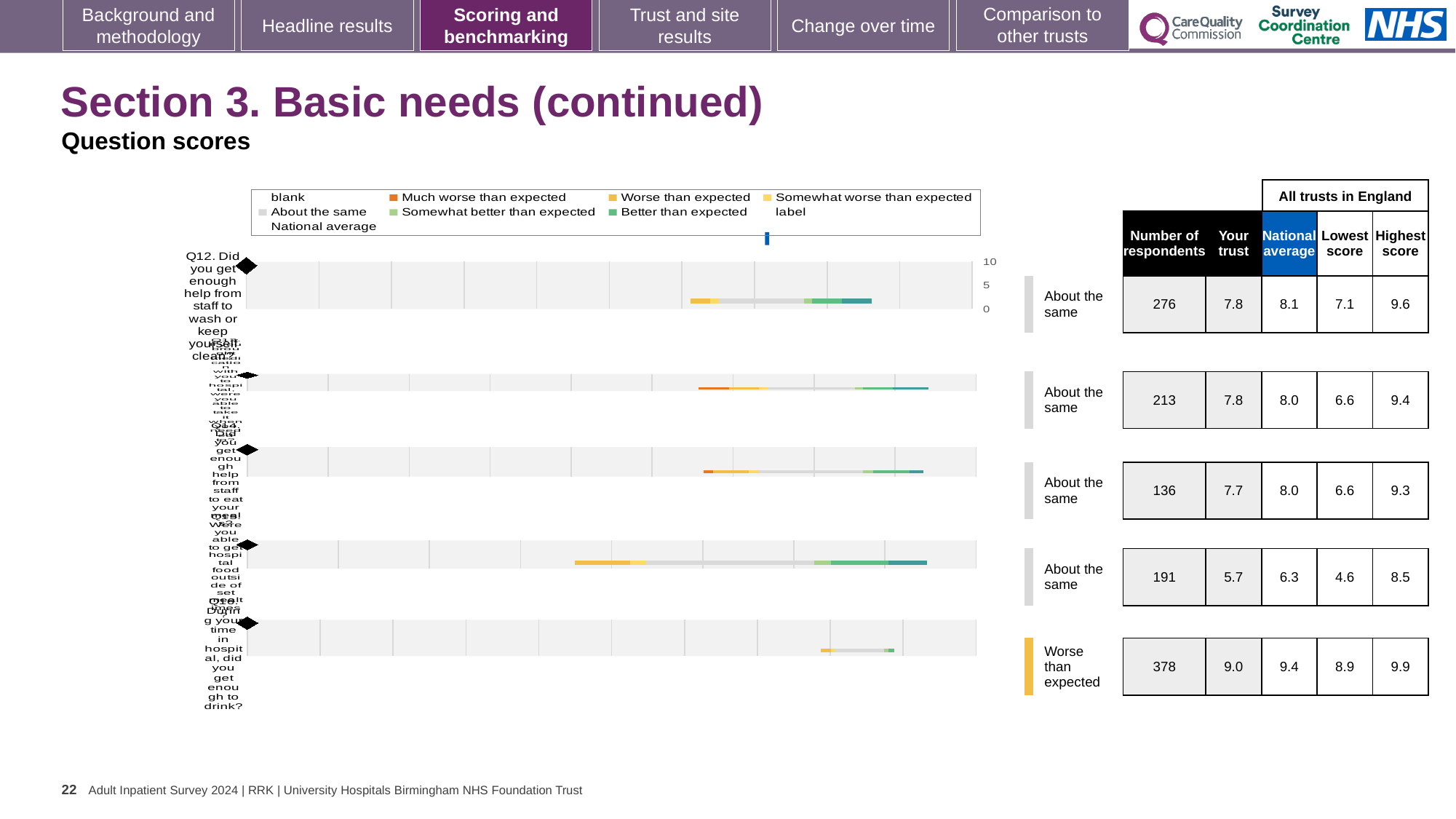
Which row has the lowest 'Your trust' score, and what is it? The fourth row (hospital food outside of set mealtimes), 5.7 Which row has the highest 'Your trust' score, and what is it? The bottom row (enough to drink), 9.0 What is the highest score across all trusts in England for the bottom row (enough to drink)? 9.9 What is the 'Your trust' score for Q12 (help from staff to wash or keep yourself clean)? 7.8 For Q12, which is larger: the 'Your trust' score or the national average? National average What is the difference between the national average and the 'Your trust' score for Q12? 0.3 What is the national average score for Q12? 8.1 How many of the five question rows are rated 'About the same'? 4 How many respondents answered Q12? 276 What kind of chart is shown on the slide? bar chart How many question rows are plotted in the chart? 5 What benchmark rating is given to the bottom row of the chart? Worse than expected